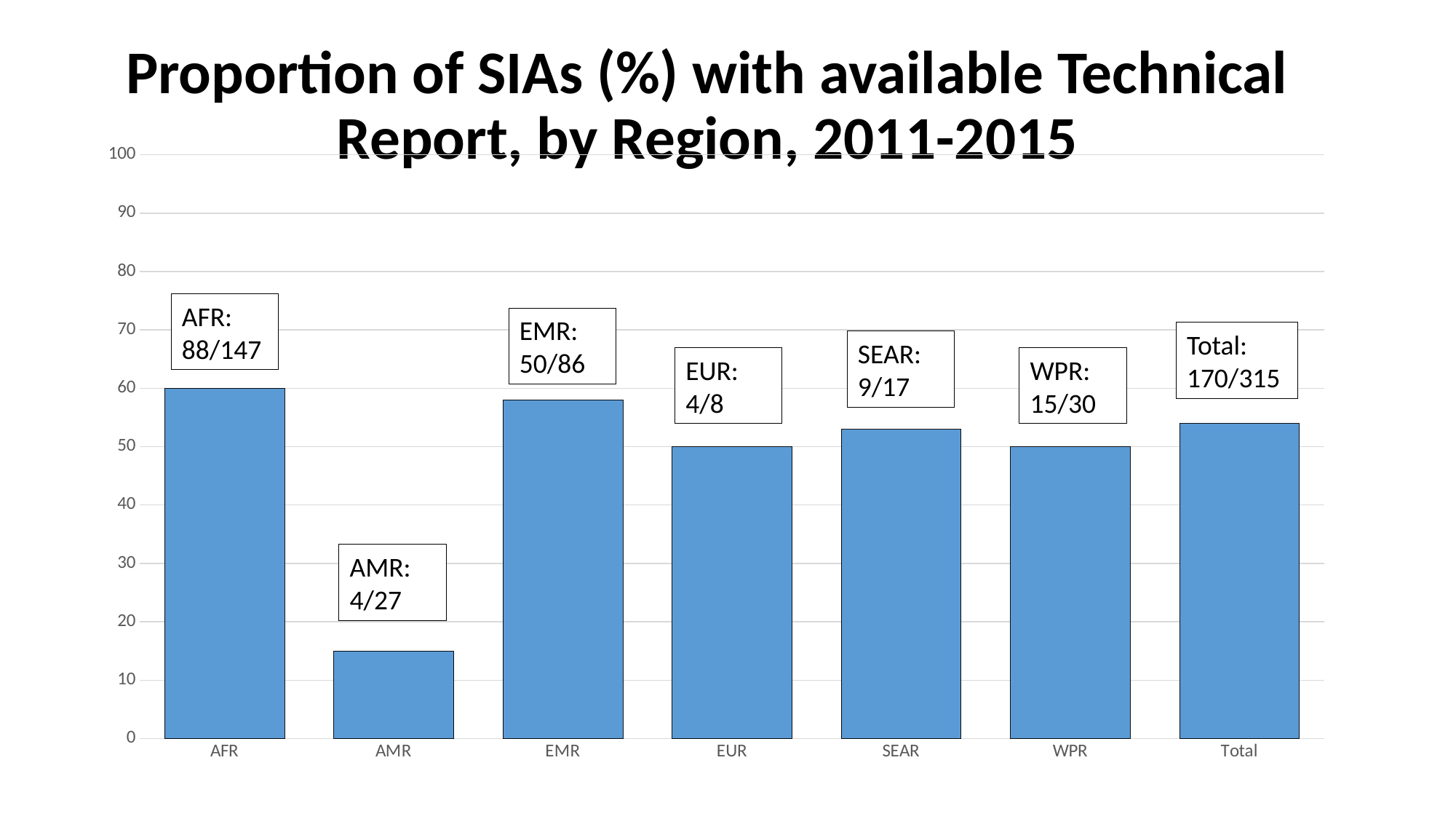
What fraction is printed in the label box above the AFR bar? 88/147 Is the value for Total greater or less than 50? greater What kind of chart is shown on the slide? bar chart What is the value for AFR? 60 Is the value for AMR greater or less than 20? less Which category has the lowest bar? AMR What is the value for EUR? 50 How many categories are shown along the x axis? 7 What fraction is printed in the label box above the Total bar? 170/315 What is the value for WPR? 50 Which is larger, the value for AFR or the value for AMR? AFR Is the value for EMR greater or less than 50? greater